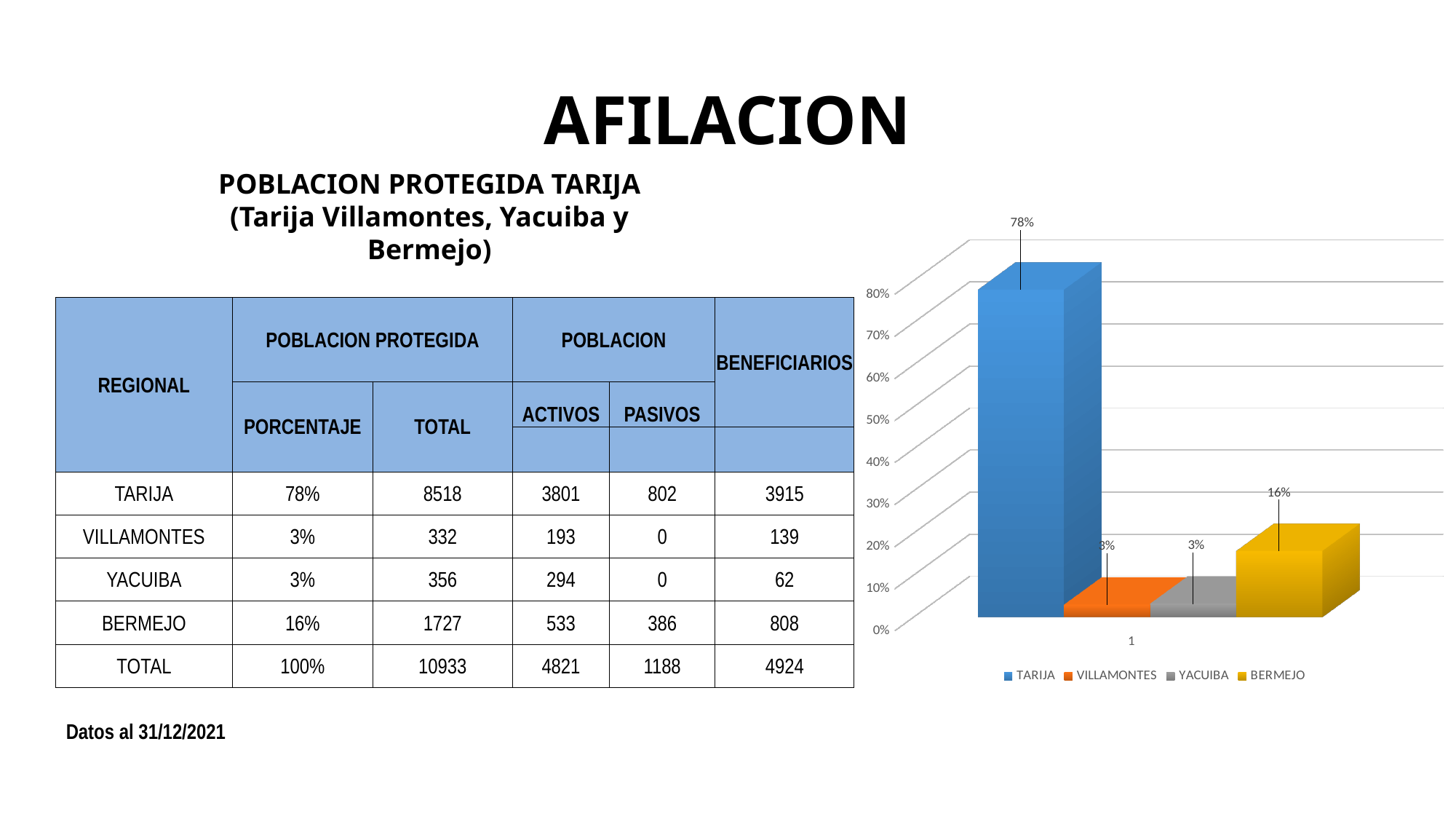
What colour is the bar for TARIJA in the chart? blue What is the difference between the TARIJA and BERMEJO values in the chart? 62% Which is larger in the chart, the value for BERMEJO or the value for VILLAMONTES? BERMEJO Is the value for BERMEJO in the chart greater or less than 20%? less What value does the chart show for BERMEJO? 16% What value does the chart show for TARIJA? 78% What value does the chart show for VILLAMONTES? 3% What type of chart is shown on the slide? bar chart Which series has the highest value in the chart? TARIJA How many series does the chart legend list? 4 What value does the chart show for YACUIBA? 3% Is the value for TARIJA in the chart greater or less than 70%? greater